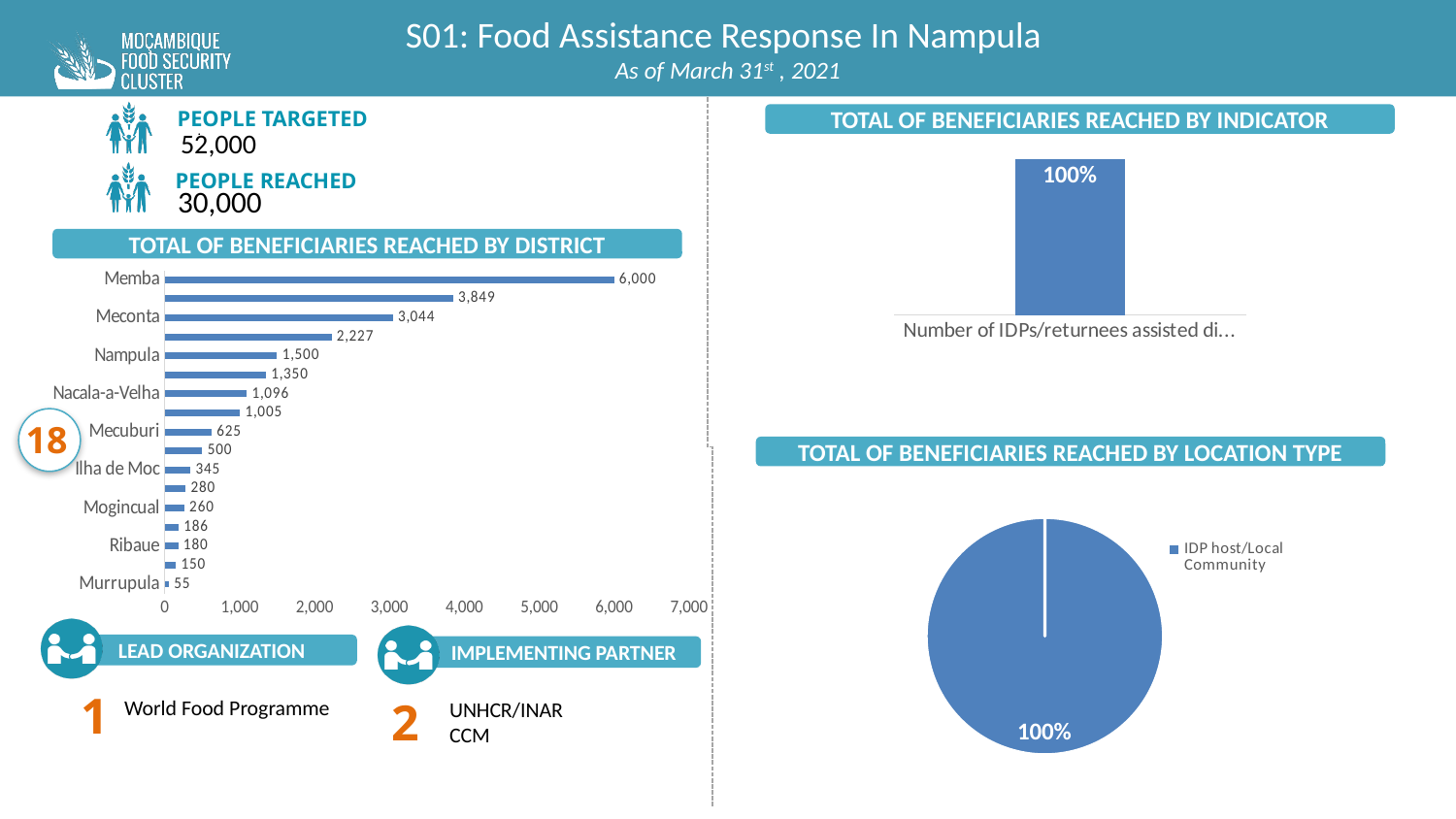
In the 'Total of Beneficiaries Reached by Indicator' chart, what value is shown on the bar? 100% In the 'Total of Beneficiaries Reached by District' chart, what is the value for Mecuburi? 625 In the 'Total of Beneficiaries Reached by District' chart, what is the difference between the values for Memba and Meconta? 2,956 In the 'Total of Beneficiaries Reached by District' chart, which district has the highest value? Memba How many entries does the legend of the 'Total of Beneficiaries Reached by Location Type' chart list? 1 In the 'Total of Beneficiaries Reached by District' chart, how many bars are plotted? 17 In the 'Total of Beneficiaries Reached by District' chart, which is larger: the value for Nampula or the value for Nacala-a-Velha? Nampula In the 'Total of Beneficiaries Reached by District' chart, what is the value for Ribaue? 180 In the 'Total of Beneficiaries Reached by District' chart, what is the value for Memba? 6,000 In the 'Total of Beneficiaries Reached by District' chart, which district has the lowest value? Murrupula What kind of chart is 'Total of Beneficiaries Reached by District'? bar chart In the 'Total of Beneficiaries Reached by Location Type' pie chart, what share does 'IDP host/Local Community' have? 100%